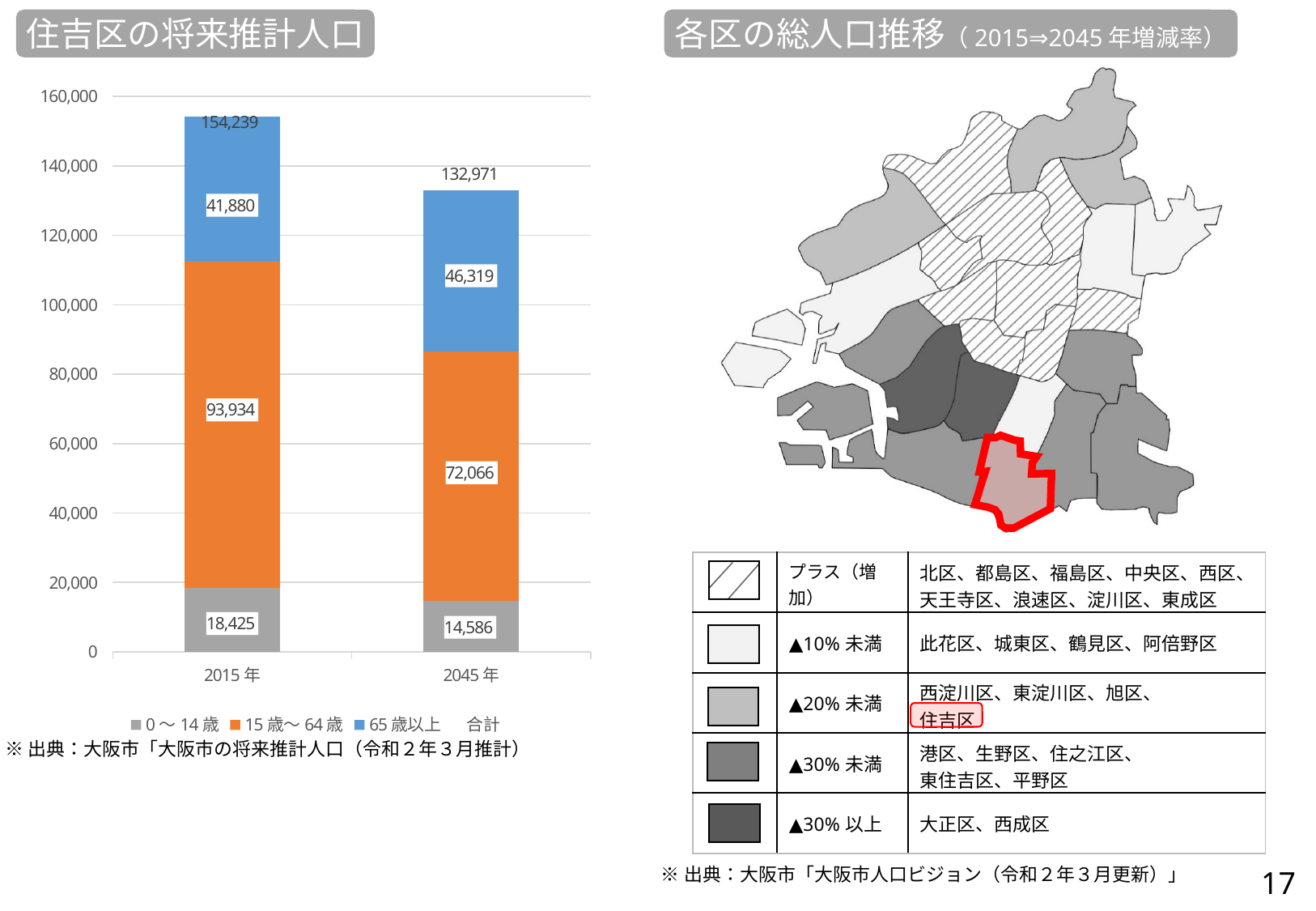
How many years (categories) are shown on the x axis of the 住吉区の将来推計人口 chart? 2 In the 住吉区の将来推計人口 chart, what is the difference between the 15歳～64歳 values for 2015年 and 2045年? 21,868 What type of chart is shown under the title 住吉区の将来推計人口? Stacked bar chart In the 住吉区の将来推計人口 chart, what is the total (合計) for 2045年? 132,971 In the 住吉区の将来推計人口 chart, which year has the larger 65歳以上 value, 2015年 or 2045年? 2045年 In the 住吉区の将来推計人口 chart, which colour represents 65歳以上? Blue In the 住吉区の将来推計人口 chart, what is the total (合計) for 2015年? 154,239 In the 住吉区の将来推計人口 chart, what is the value for 0～14歳 in 2015年? 18,425 In the 住吉区の将来推計人口 chart, what is the value for 65歳以上 in 2045年? 46,319 In the 住吉区の将来推計人口 chart, which age group has the smallest value in 2045年? 0～14歳 In the 住吉区の将来推計人口 chart, what is the value for 15歳～64歳 in 2015年? 93,934 In the 住吉区の将来推計人口 chart, does the total population rise or fall from 2015年 to 2045年? Fall